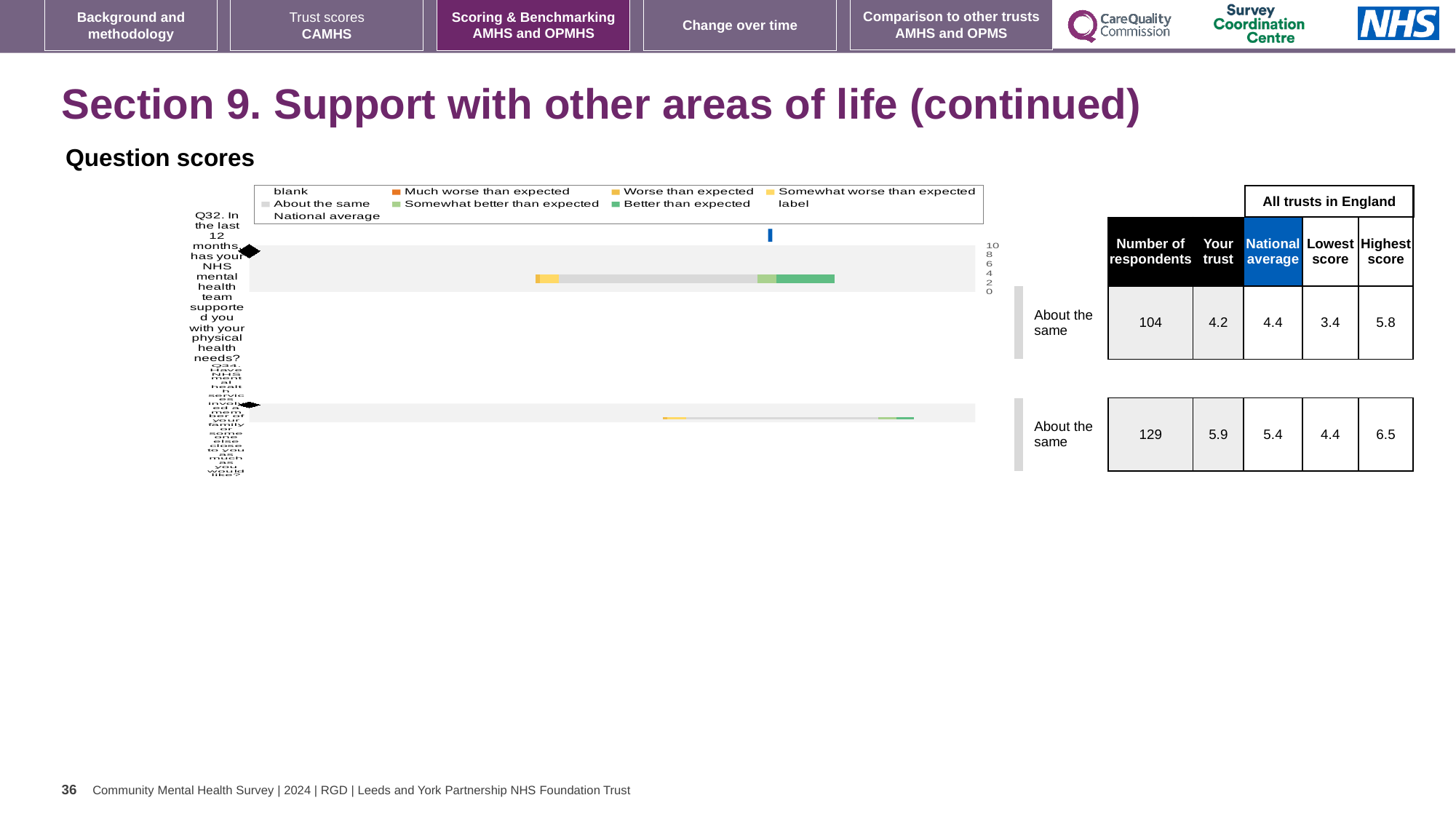
For Q32, which is larger: the 'Your trust' score or the national average? national average What is the difference between the 'Your trust' score and the national average for Q34? 0.5 How many questions (categories) are plotted in the Question scores chart? 2 How many entries does the legend of the Question scores chart list? 9 What is the national average score for Q34 (involving family or someone close)? 5.4 What benchmark category is shown for both Q32 and Q34 in the Question scores chart? About the same What is the lowest score among all trusts in England for Q32? 3.4 What is the number of respondents for Q32? 104 What kind of chart is shown under 'Question scores'? bar chart What is the 'Your trust' score for Q32 (support with physical health needs)? 4.2 What is the highest score among all trusts in England for Q34? 6.5 Which question has the higher 'Your trust' score, Q32 or Q34? Q34